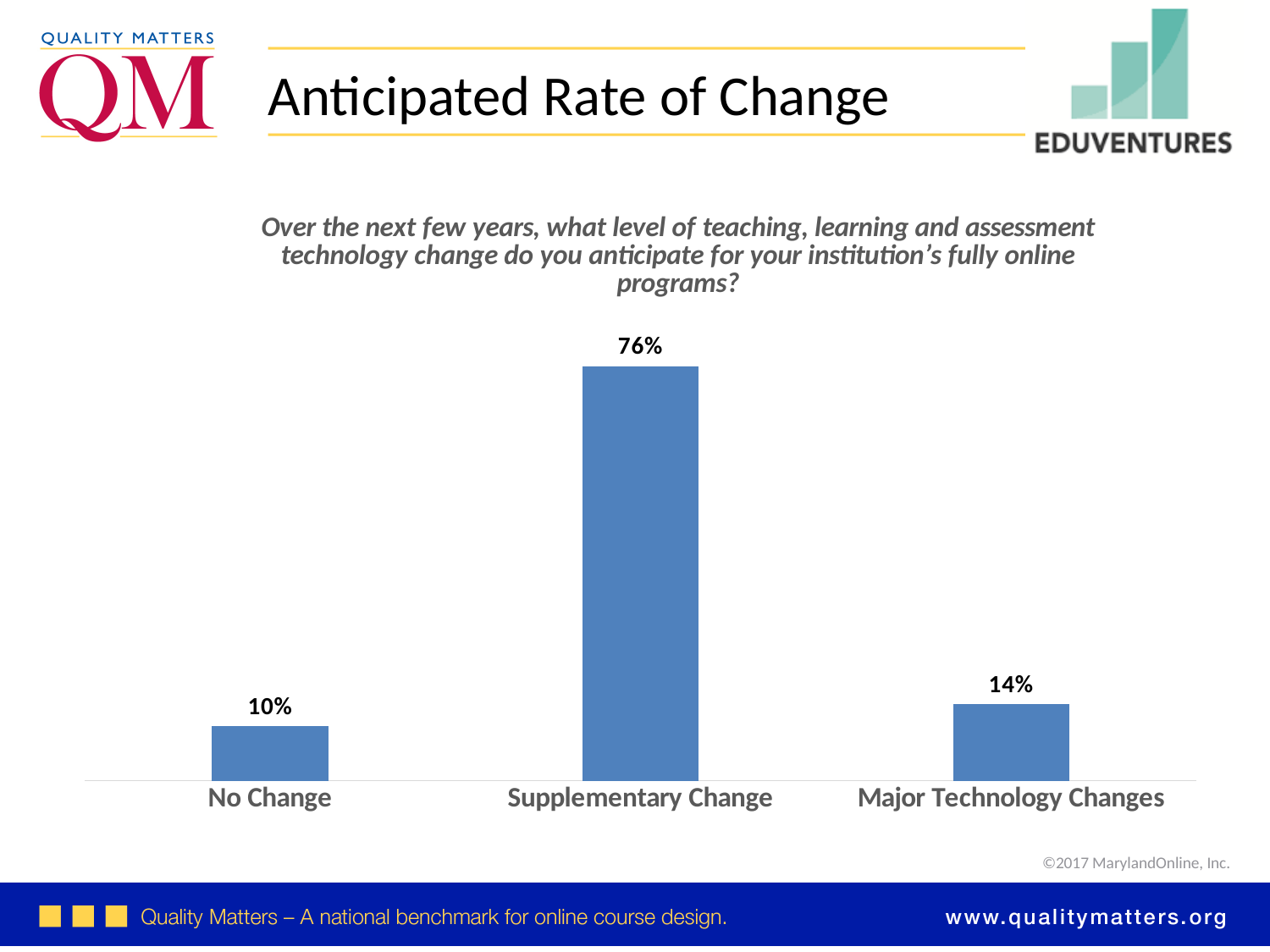
What is the total of the three percentages shown in the chart? 100% What kind of chart is shown on the slide? Bar chart Which is larger, the value for No Change or the value for Major Technology Changes? Major Technology Changes How many categories are shown in the chart? 3 Which category has the lowest percentage? No Change What percentage of respondents anticipate No Change? 10% What is the difference in percentage points between Major Technology Changes and No Change? 4 Which category has the highest percentage? Supplementary Change What percentage of respondents anticipate Major Technology Changes? 14% What is the title of the slide containing the chart? Anticipated Rate of Change What is the difference in percentage points between Supplementary Change and Major Technology Changes? 62 What percentage of respondents anticipate Supplementary Change? 76%